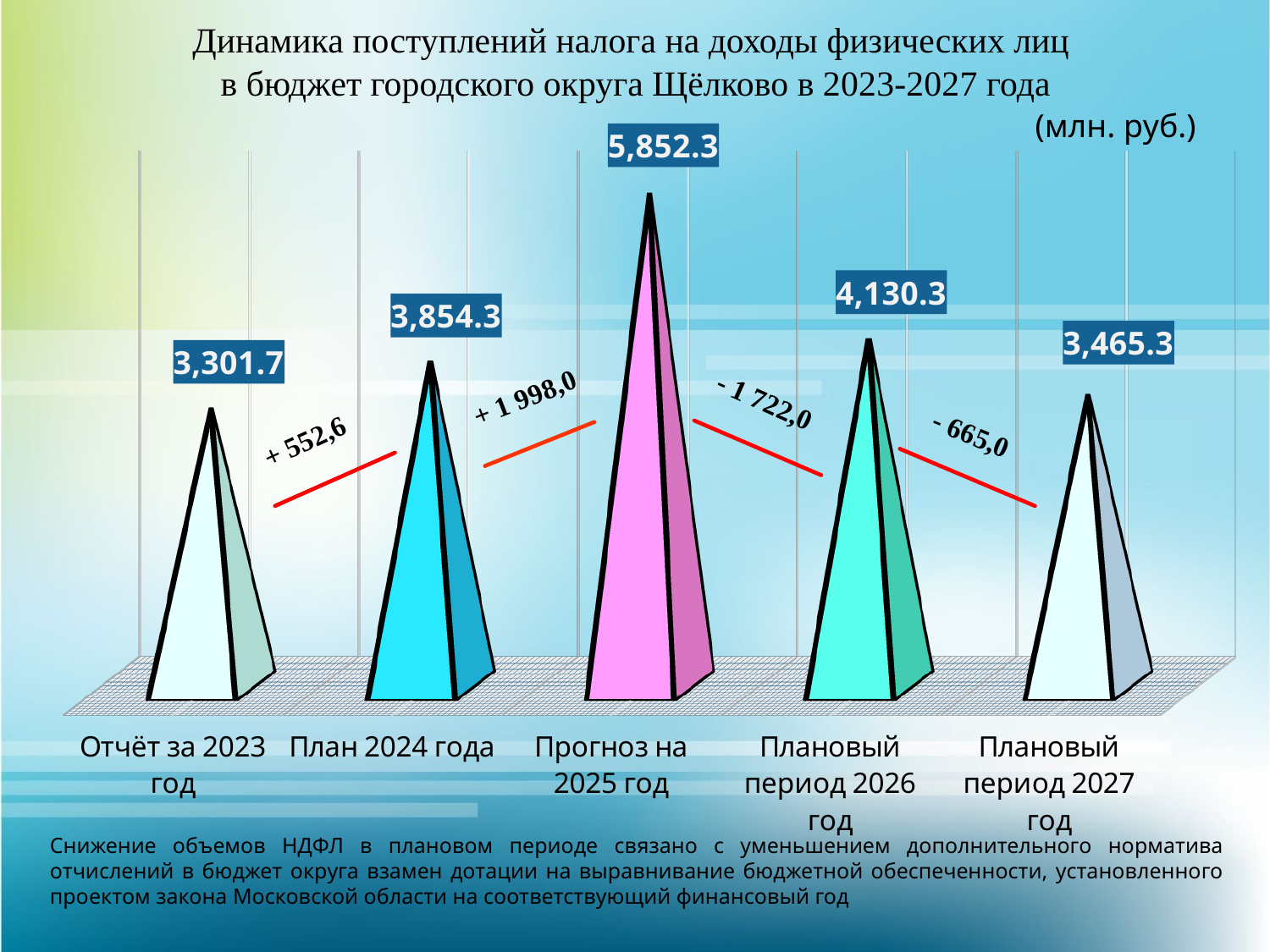
Which is larger: the value for «Плановый период 2026 год» or «Плановый период 2027 год»? Плановый период 2026 год What is the value for «Плановый период 2027 год»? 3,465.3 What is the difference between the values for «План 2024 года» and «Отчёт за 2023 год»? 552.6 In what units are the values on the chart given? млн. руб. Which category has the lowest value? Отчёт за 2023 год What kind of chart is shown on the slide? Bar chart What is the difference between the values for «Прогноз на 2025 год» and «Плановый период 2026 год»? 1,722.0 What is the value for «Прогноз на 2025 год»? 5,852.3 Which category has the highest value? Прогноз на 2025 год What is the value for «Отчёт за 2023 год»? 3,301.7 Do the values rise or fall from «Прогноз на 2025 год» to «Плановый период 2027 год»? Fall How many categories are shown on the chart? 5